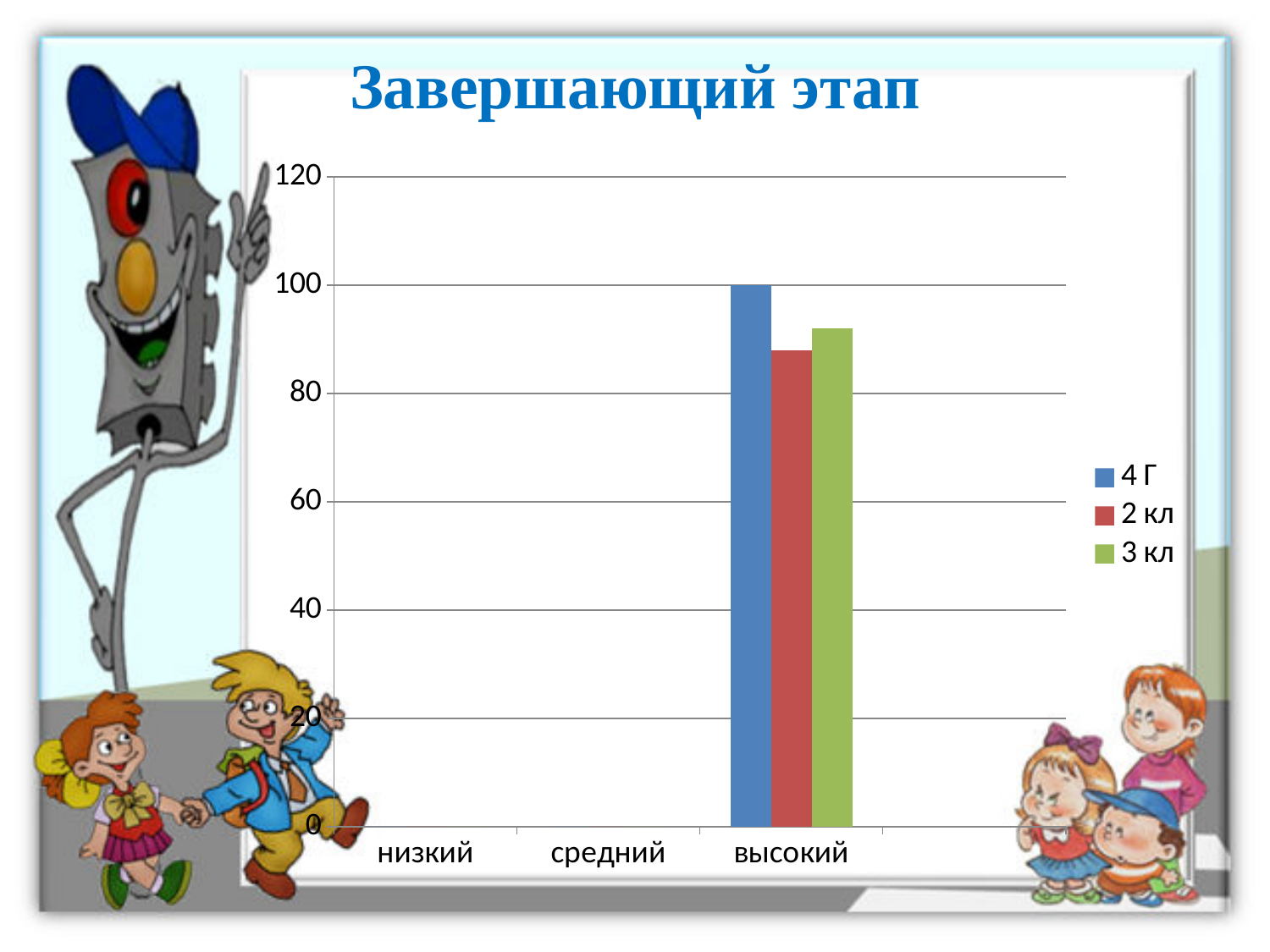
In the высокий category, which is larger: 2 кл or 3 кл? 3 кл What kind of chart is shown on the slide? bar chart Is the value for 3 кл in the высокий category greater or less than 100? less What colour represents the 3 кл series in the legend? green What is the value for 4 Г in the высокий category? 100 How many categories are shown on the x axis? 3 Which series has the highest bar in the высокий category? 4 Г Is the value for 2 кл in the высокий category greater or less than 80? greater Which series has the lowest bar in the высокий category? 2 кл How many series does the legend list? 3 In the высокий category, which is larger: 4 Г or 3 кл? 4 Г What is the title of the chart? Завершающий этап